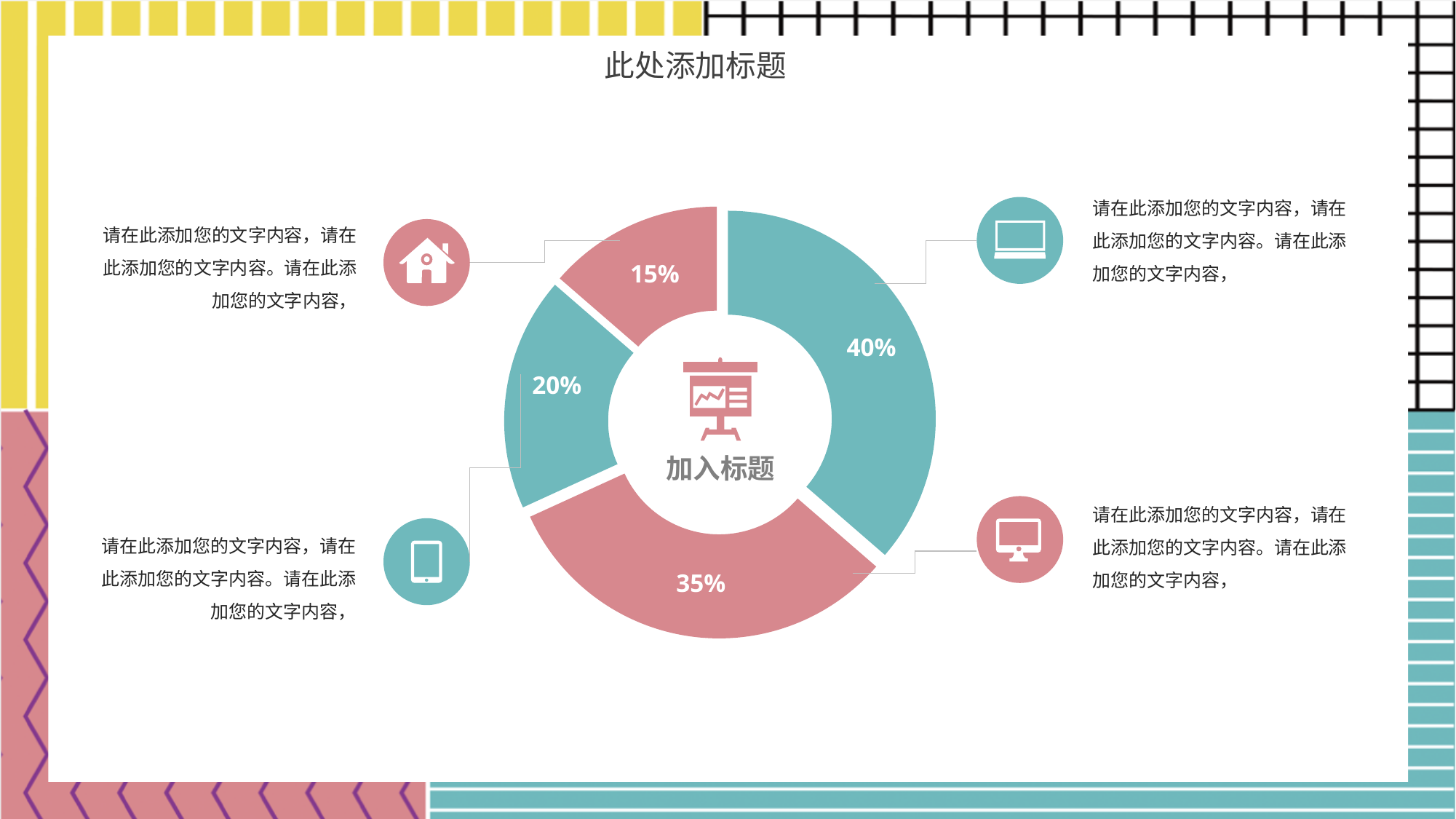
What value is printed on the teal slice on the left side of the donut chart? 20% What is the difference between the 35% slice and the 20% slice on the donut chart? 15% Which is larger on the donut chart: the slice on the right side or the slice at the bottom? The slice on the right side (40%) What is the largest value shown on the donut chart? 40% What is the difference between the largest slice (40%) and the smallest slice (15%) on the donut chart? 25% How many slices does the donut chart have? 4 What is the title of the slide containing the donut chart? 此处添加标题 What text is shown in the centre of the donut chart? 加入标题 What is the combined share of the two pink slices on the donut chart? 50% What value is printed on the pink slice at the top of the donut chart? 15% What kind of chart is shown on the slide? Pie chart (donut) What is the smallest value shown on the donut chart? 15%